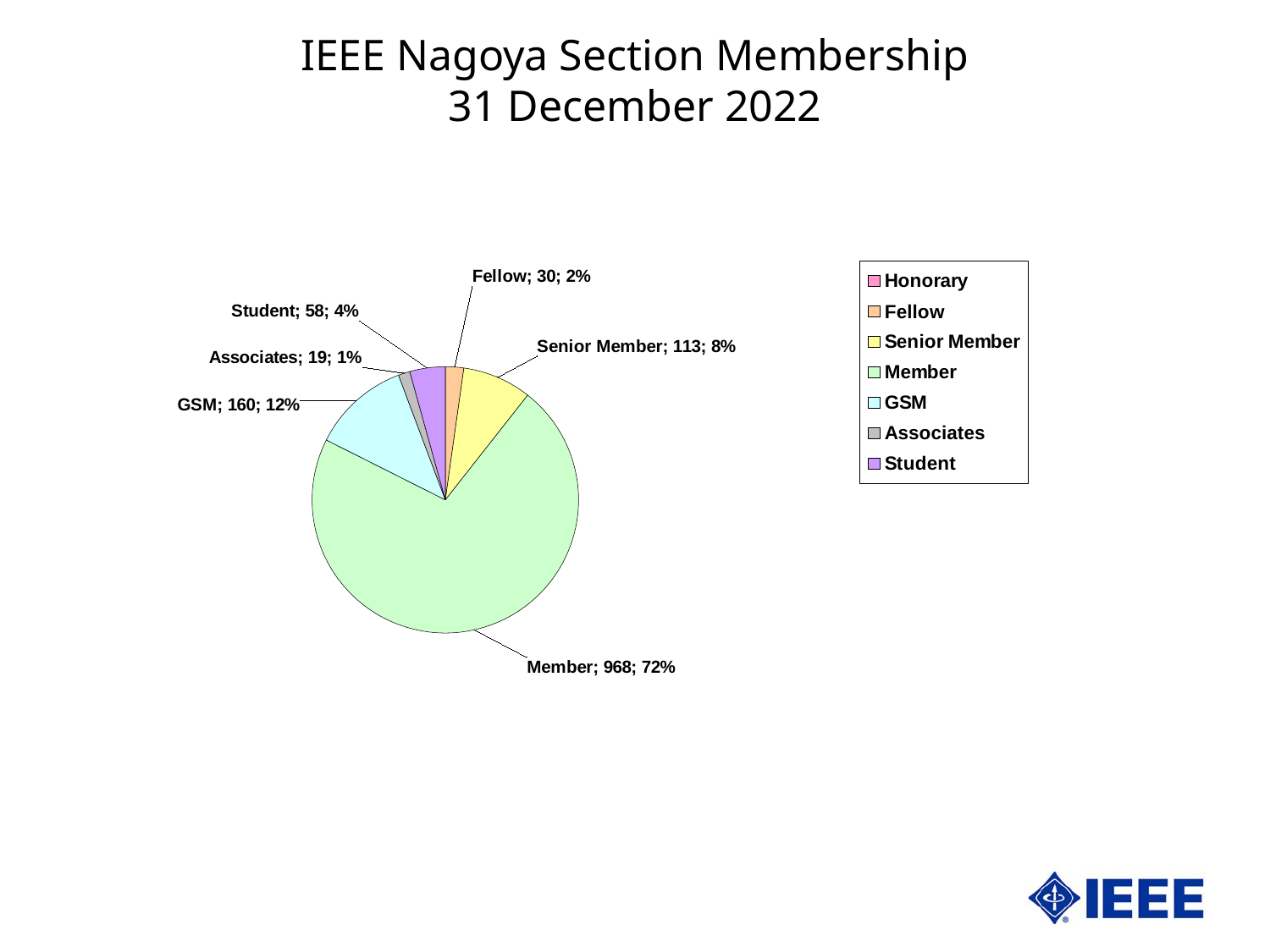
What is the value shown for Senior Member? 113 What is the value shown for Associates? 19 What is the difference between the Member value and the GSM value? 808 What is the title of the slide? IEEE Nagoya Section Membership 31 December 2022 What type of chart is shown on the slide? pie chart How many members are in the Member category? 968 What is the difference between the Student value and the Fellow value? 28 Which labelled category has the smallest slice of the pie? Associates How many entries does the legend list? 7 Which is larger, the value for GSM or the value for Senior Member? GSM Which category has the largest slice of the pie? Member What percentage share does GSM have in the pie chart? 12%